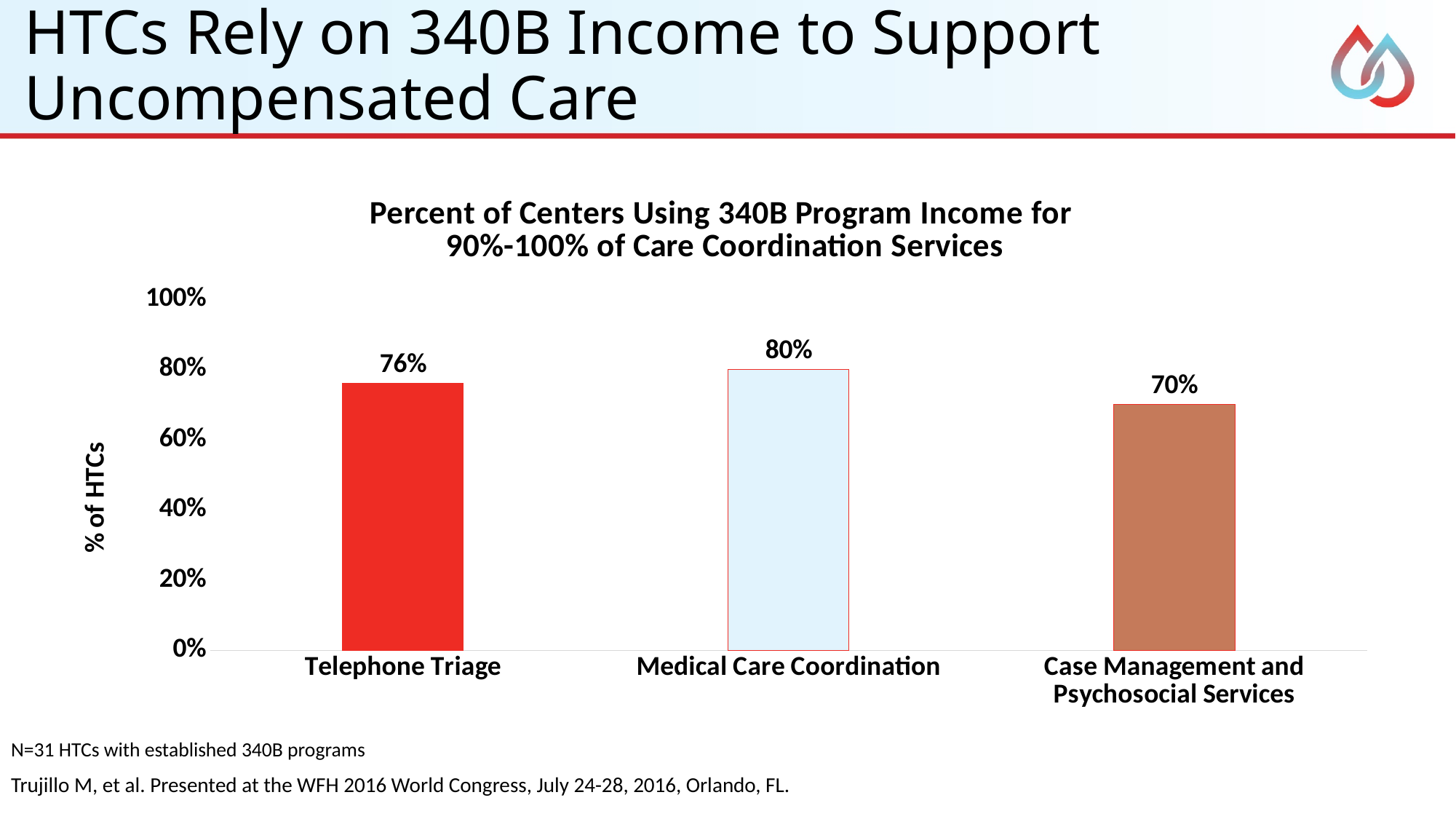
Is the value for Case Management and Psychosocial Services greater or less than 80%? less What is the difference between the values for Telephone Triage and Case Management and Psychosocial Services? 6% What is the value shown for Medical Care Coordination? 80% Which category has the highest percentage of HTCs? Medical Care Coordination What kind of chart is shown on the slide? Bar chart Which is larger, the value for Telephone Triage or the value for Case Management and Psychosocial Services? Telephone Triage What is the label of the y axis of the chart? % of HTCs What is the value shown for Case Management and Psychosocial Services? 70% How many categories are shown on the x axis of the chart? 3 Which category has the lowest percentage of HTCs? Case Management and Psychosocial Services What percentage of HTCs use 340B program income for 90%-100% of Telephone Triage services? 76% What is the difference between the values for Medical Care Coordination and Telephone Triage? 4%